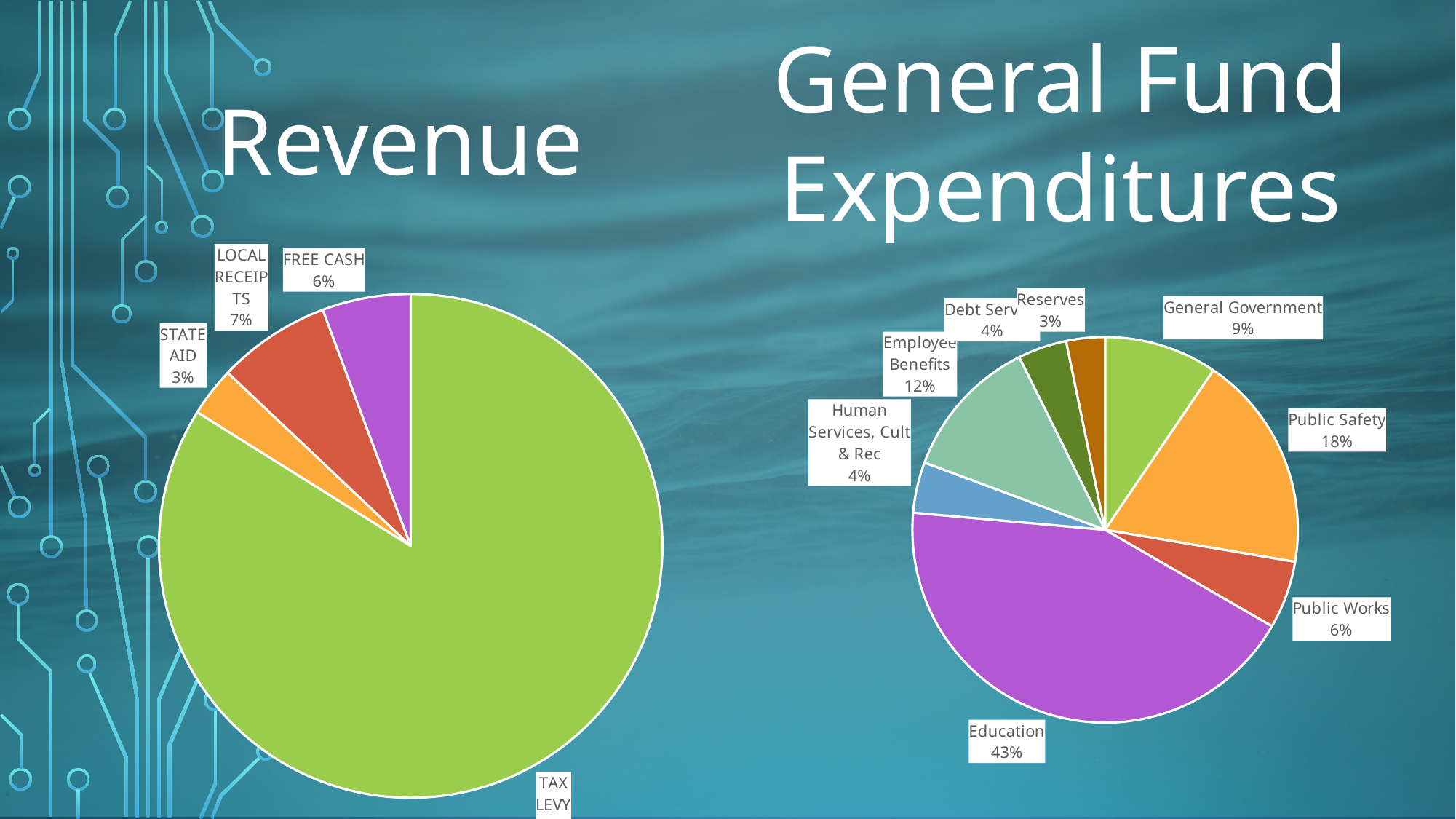
In the Revenue chart, which category has the largest slice? TAX LEVY In the Revenue chart, how many slices are there? 4 In the General Fund Expenditures chart, which category has the smallest slice? Reserves In the Revenue chart, what share does FREE CASH have? 6% In the General Fund Expenditures chart, what is the difference between the Public Safety and General Government shares? 9% In the Revenue chart, what share does LOCAL RECEIPTS have? 7% In the General Fund Expenditures chart, how many slices are there? 8 In the General Fund Expenditures chart, what share does Employee Benefits have? 12% What type of chart is the Revenue chart? pie chart In the Revenue chart, which is larger, LOCAL RECEIPTS or STATE AID? LOCAL RECEIPTS